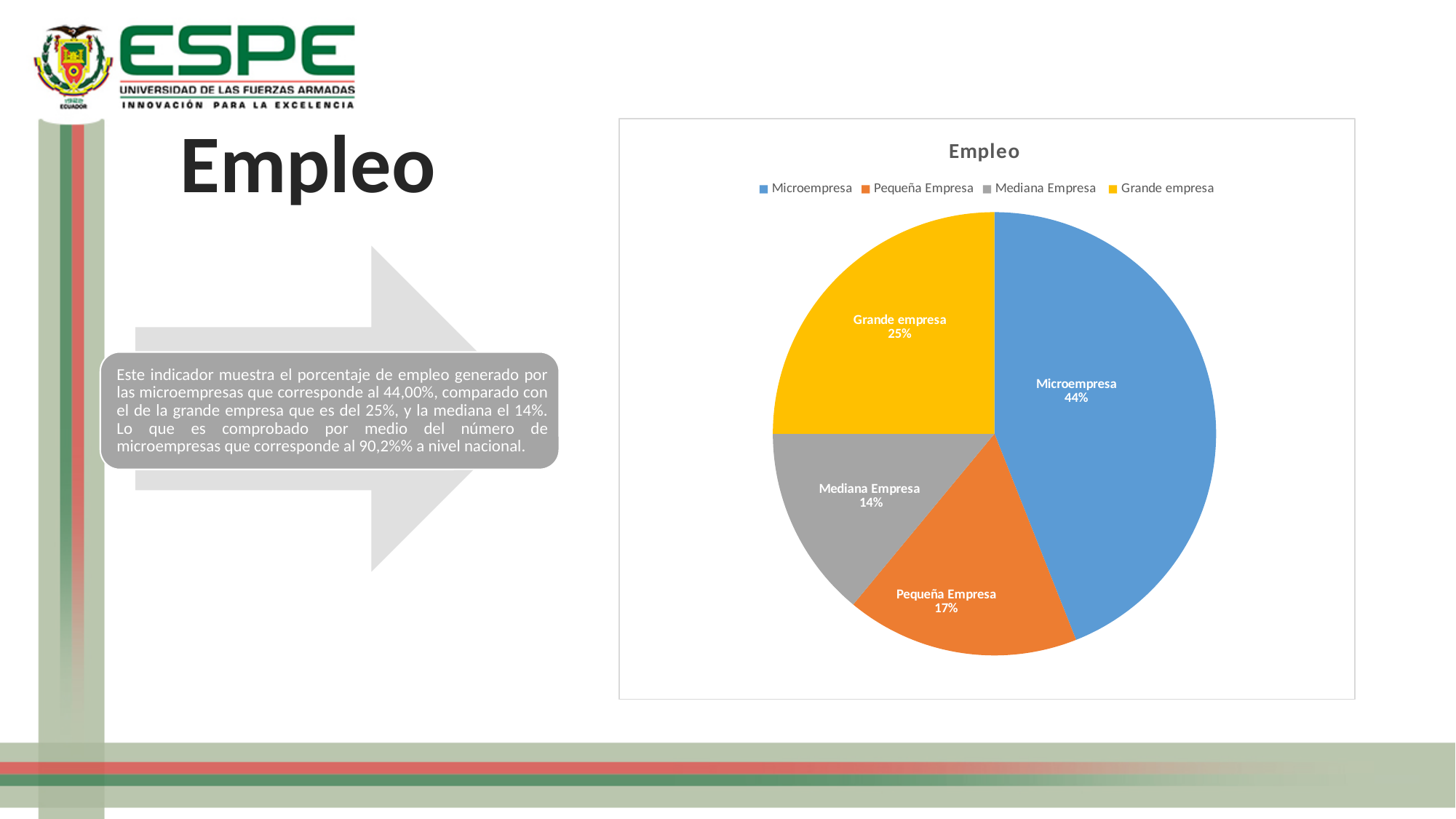
What is the difference in percentage points between Microempresa and Grande empresa? 19 How many categories are shown in the pie chart? 4 What share of the pie does Pequeña Empresa represent? 17% Which is larger, the share for Pequeña Empresa or the share for Mediana Empresa? Pequeña Empresa What share of the pie does Mediana Empresa represent? 14% What share of the pie does Microempresa represent? 44% What colour is the Grande empresa slice? yellow Which category has the largest slice of the pie? Microempresa What type of chart is shown on the slide? pie chart What is the title of the chart? Empleo Which category has the smallest slice of the pie? Mediana Empresa